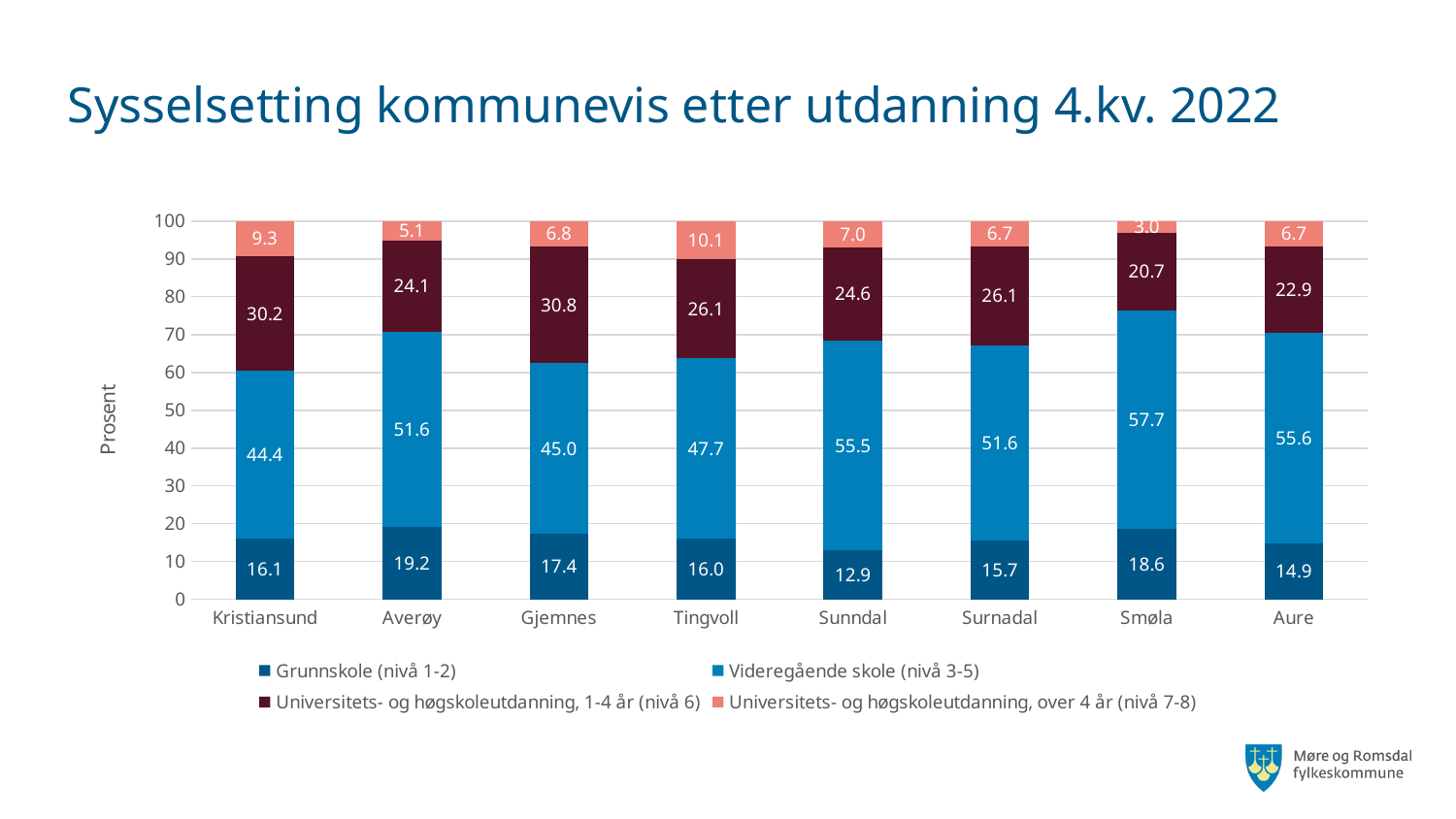
What is the difference between the Videregående skole (nivå 3-5) values for Smøla and Kristiansund? 13.3 What is the value for Universitets- og høgskoleutdanning, 1-4 år (nivå 6) in Gjemnes? 30.8 What is the value for Grunnskole (nivå 1-2) in Averøy? 19.2 How many municipalities are shown on the x axis? 8 What is the value for Universitets- og høgskoleutdanning, over 4 år (nivå 7-8) in Tingvoll? 10.1 Which is larger: the Universitets- og høgskoleutdanning, 1-4 år (nivå 6) value for Kristiansund or for Aure? Kristiansund Which municipality has the lowest value for Universitets- og høgskoleutdanning, over 4 år (nivå 7-8)? Smøla What kind of chart is shown on the slide? Stacked bar chart Which municipality has the highest value for Videregående skole (nivå 3-5)? Smøla What is the value for Videregående skole (nivå 3-5) in Sunndal? 55.5 Which municipality has the lowest value for Grunnskole (nivå 1-2)? Sunndal How many series does the legend list? 4